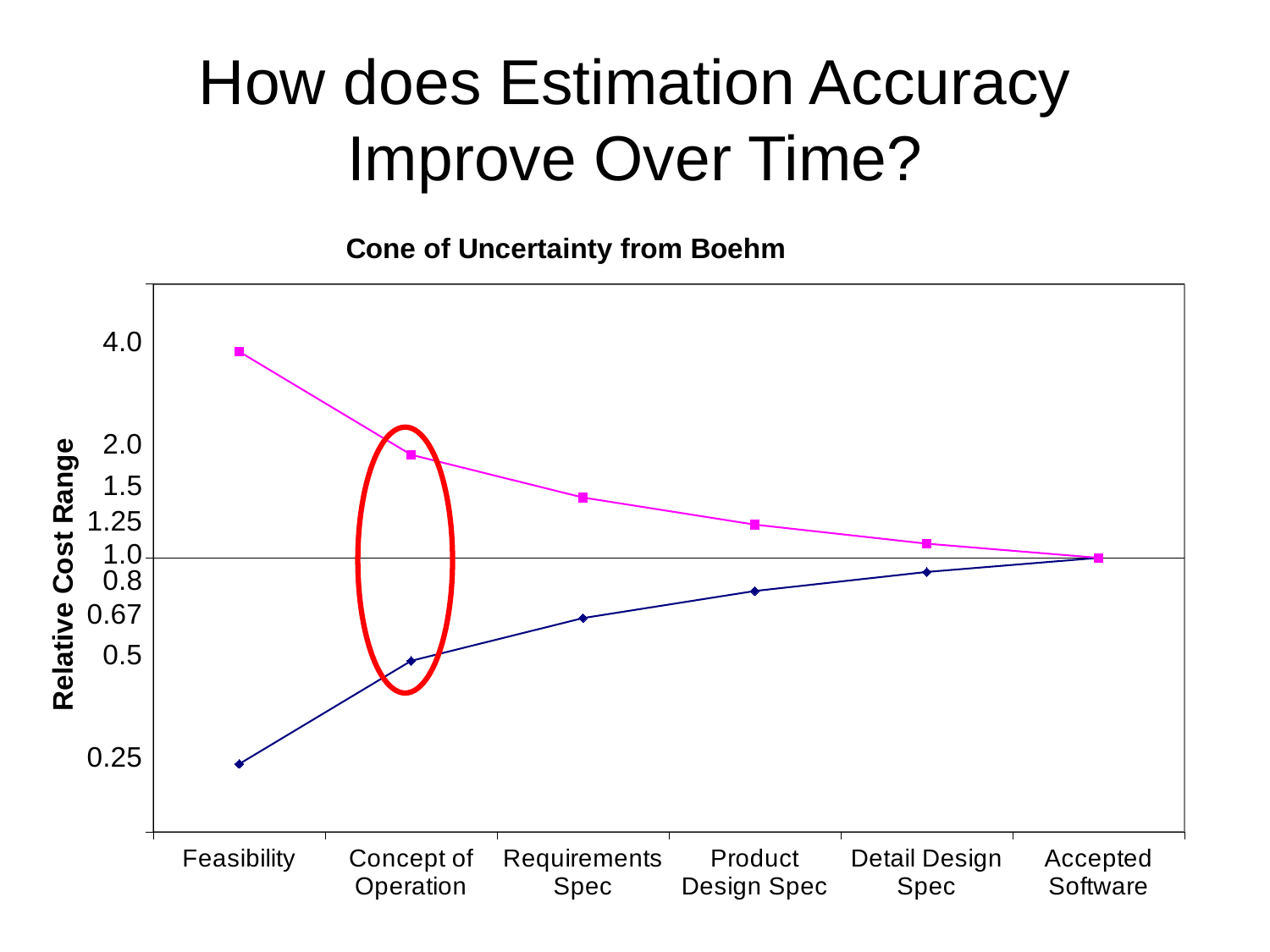
At which stage is the upper (pink) line at its highest value? Feasibility Is the value of the upper (pink) line at Requirements Spec greater or less than 1.25? greater Is the value of the lower (blue) line at Feasibility greater or less than 0.5? less At which stage do the two lines meet at a relative cost range of 1.0? Accepted Software Is the value of the upper (pink) line at Feasibility greater or less than 2.0? greater Does the lower (blue) line rise or fall from Feasibility to Accepted Software? rise How many categories are shown along the x axis? 6 Does the upper (pink) line rise or fall from Feasibility to Accepted Software? fall What is the title of the chart? Cone of Uncertainty from Boehm What kind of chart is shown on the slide? line chart What is the label of the vertical axis? Relative Cost Range